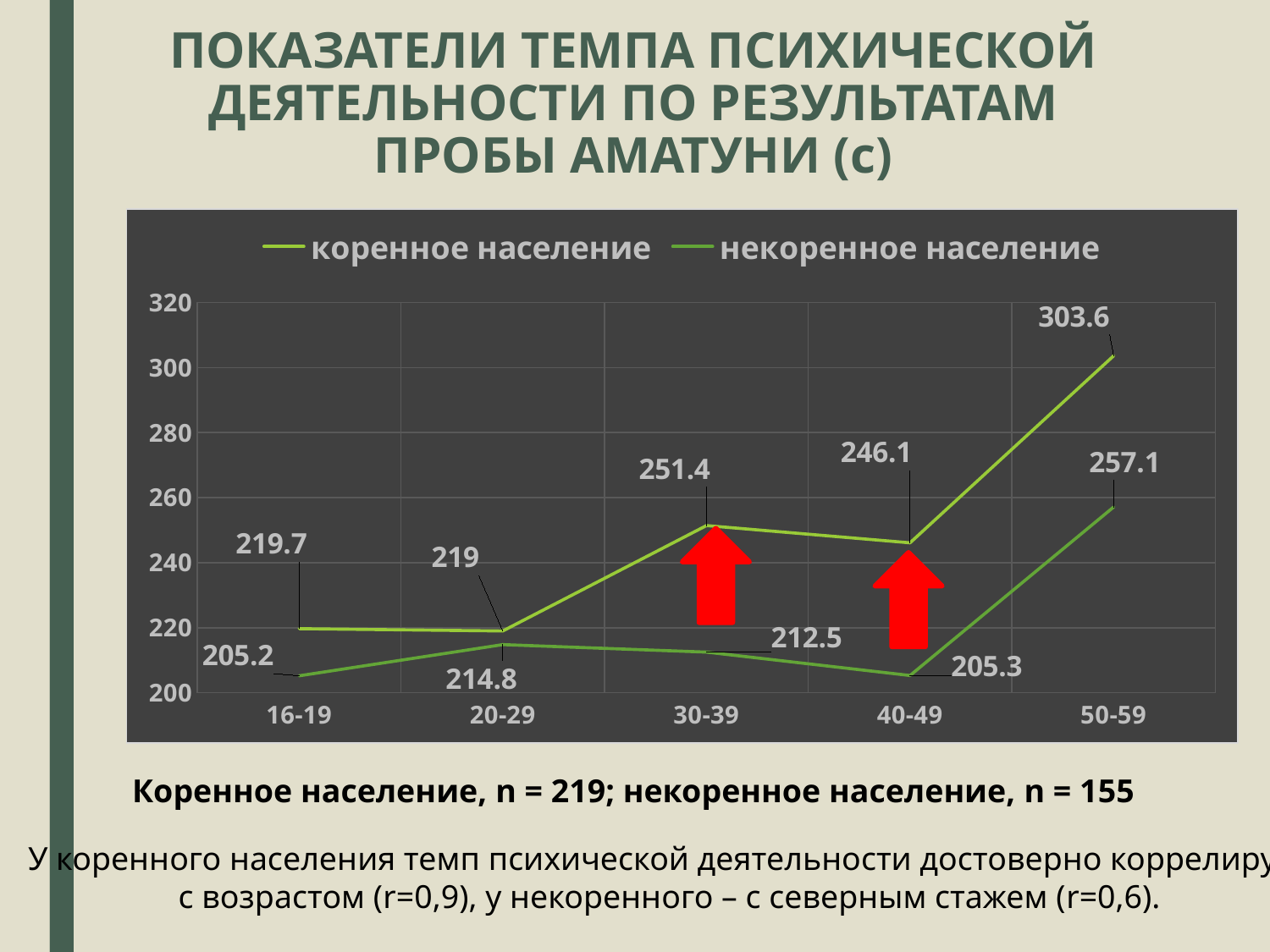
How many series does the legend list? 2 What is the value for коренное население in the 30-39 age group? 251.4 How many age groups are shown on the x axis? 5 What is the difference between коренное население and некоренное население in the 50-59 age group? 46.5 What is the value for некоренное население in the 20-29 age group? 214.8 Which is larger in the 40-49 age group: коренное население or некоренное население? коренное население Does the value for коренное население rise or fall from the 40-49 to the 50-59 age group? rise Which age group has the lowest value for коренное население? 20-29 What is the value for коренное население in the 50-59 age group? 303.6 Is the value for коренное население in the 40-49 age group greater or less than 240? greater Which age group has the highest value for некоренное население? 50-59 What type of chart is shown on the slide? line chart